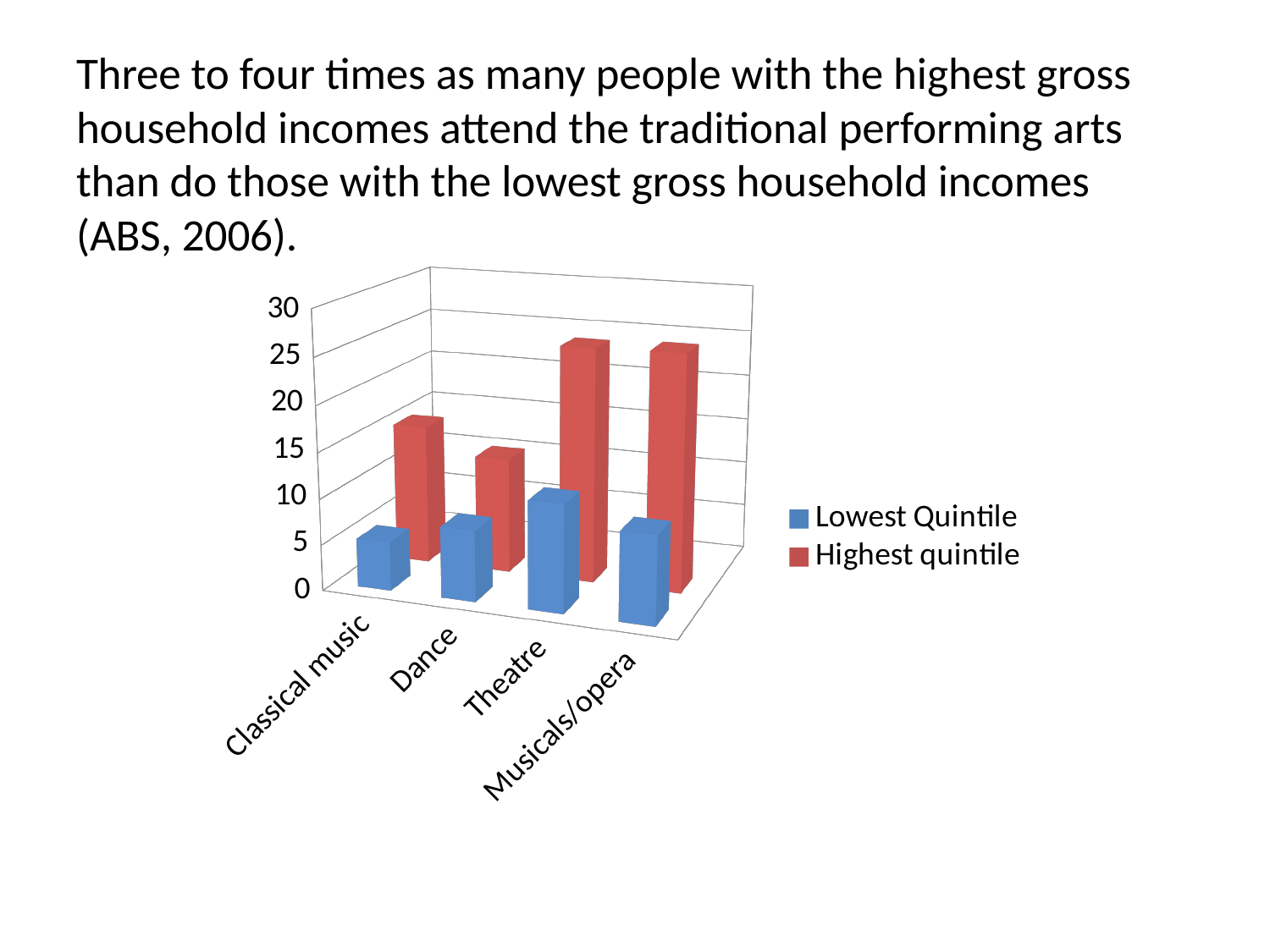
How many series does the legend list? 2 How many categories are shown on the x axis? 4 Which category has the lowest Highest quintile value? Dance Which two series are listed in the legend? Lowest Quintile and Highest quintile Is the Highest quintile value for Theatre greater or less than 20? greater Is the Highest quintile value for Dance greater or less than 20? less Is the Highest quintile value for Musicals/opera greater or less than 20? greater For Classical music, which series has the larger value, Lowest Quintile or Highest quintile? Highest quintile Within the Highest quintile series, which is larger, Theatre or Dance? Theatre What kind of chart is shown on the slide? bar chart